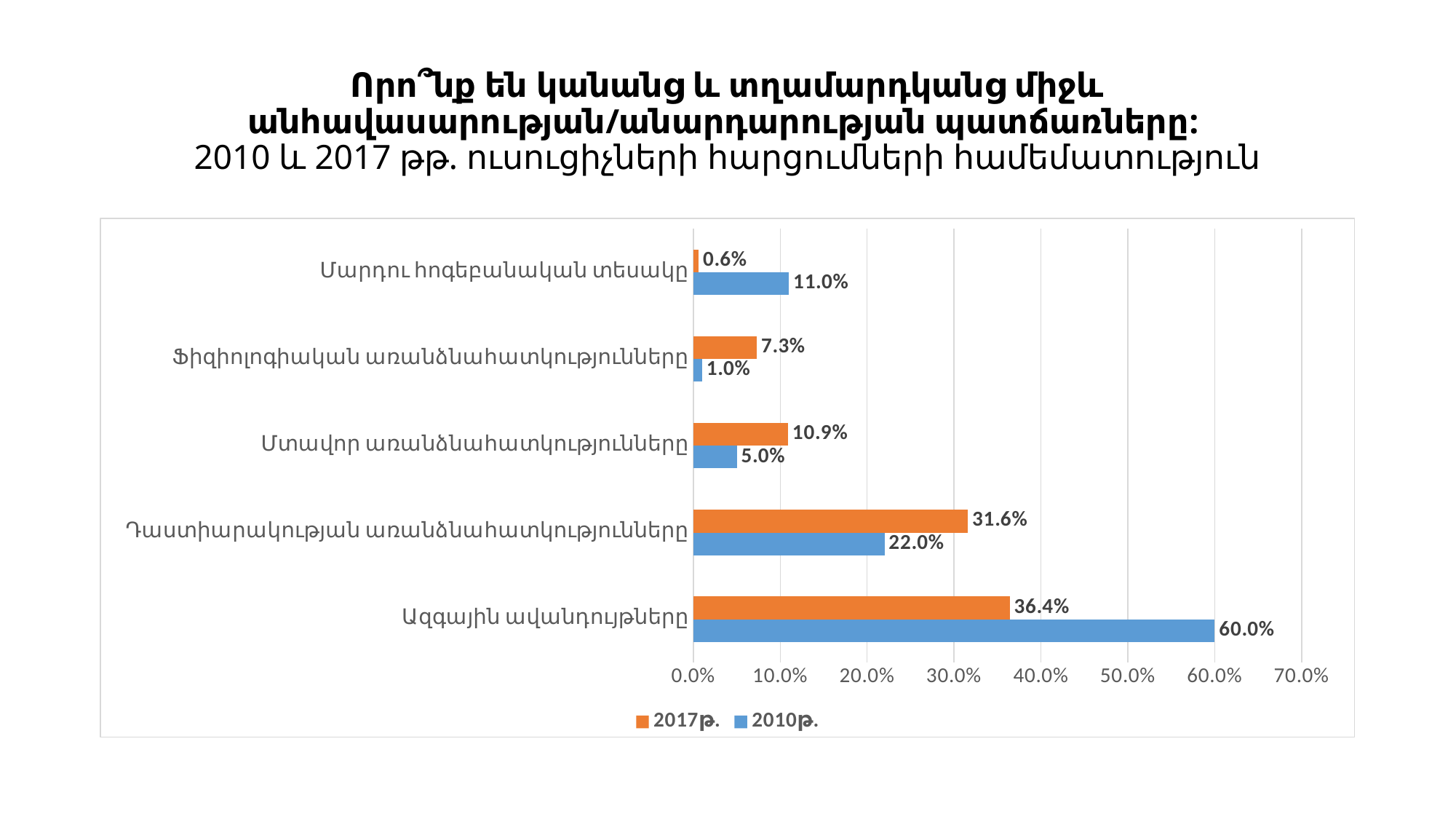
What is the 2010թ. value for Ազգային ավանդույթները? 60.0% For Ֆիզիոլոգիական առանձնահատկությունները, which is larger: the 2017թ. value or the 2010թ. value? 2017թ. What is the 2017թ. value for Դաստիարակության առանձնահատկությունները? 31.6% What kind of chart is shown on the slide? bar chart What is the 2017թ. value for Մարդու հոգեբանական տեսակը? 0.6% Which category has the highest 2010թ. value? Ազգային ավանդույթները Which colour represents the 2010թ. series? blue Is the 2010թ. value for Դաստիարակության առանձնահատկությունները greater or less than 30.0%? less How many categories are shown on the chart? 5 Which category has the lowest 2017թ. value? Մարդու հոգեբանական տեսակը How many series does the legend list? 2 What is the difference between the 2010թ. and 2017թ. values for Ազգային ավանդույթները? 23.6%